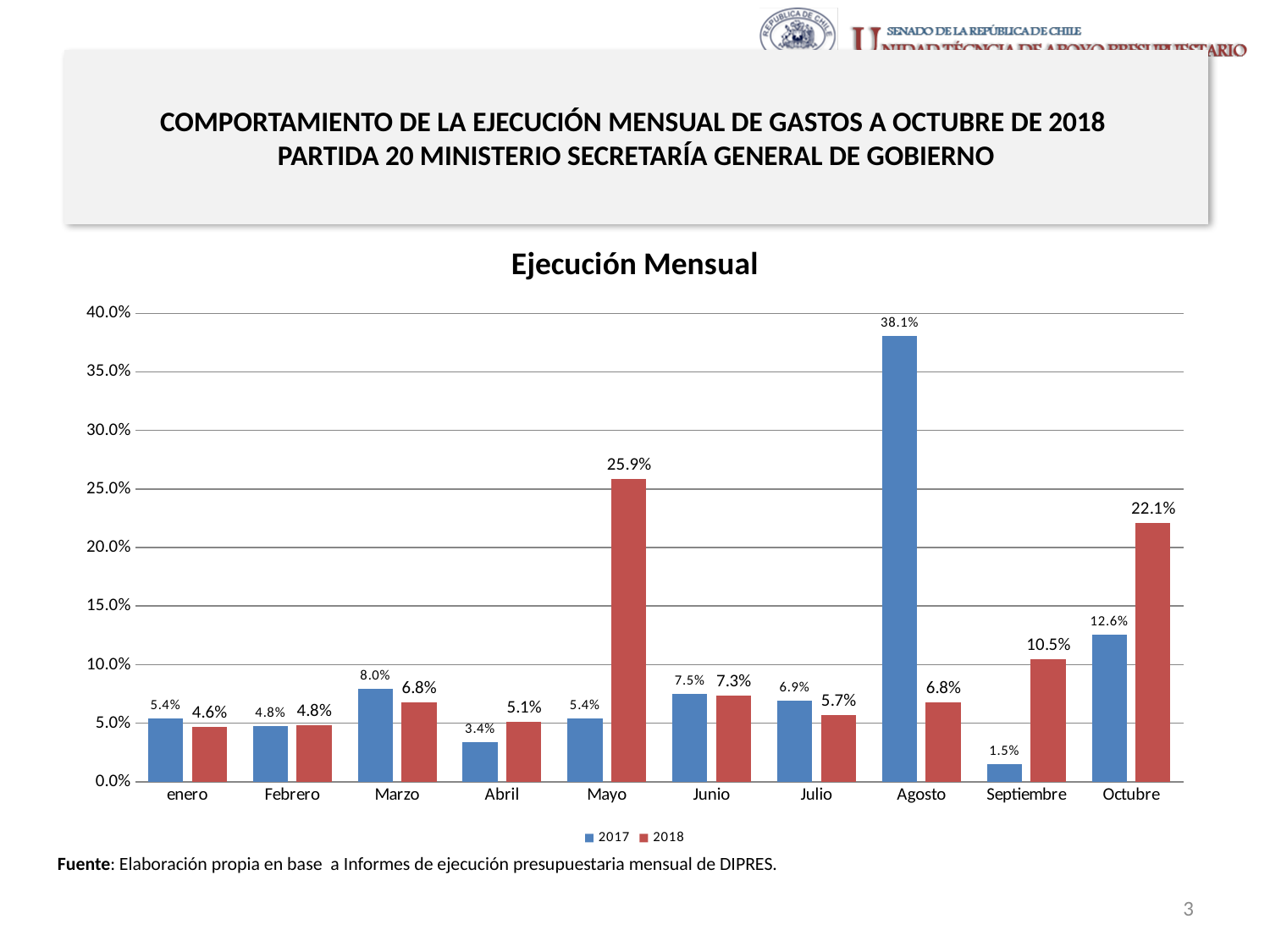
What is the value for 2017 in Septiembre? 1.5% Which month has the highest value for 2017? Agosto Which is larger in Julio, the 2017 value or the 2018 value? 2017 Which month has the lowest value for 2018? enero How many months are shown on the x axis? 10 What is the value for 2017 in Abril? 3.4% Is the value for 2017 in Agosto greater or less than 35.0%? greater How many series does the legend list? 2 What is the title of the chart? Ejecución Mensual What is the value for 2018 in Mayo? 25.9% What is the difference between the 2018 and 2017 values in Octubre? 9.5% What type of chart is shown on the slide? bar chart